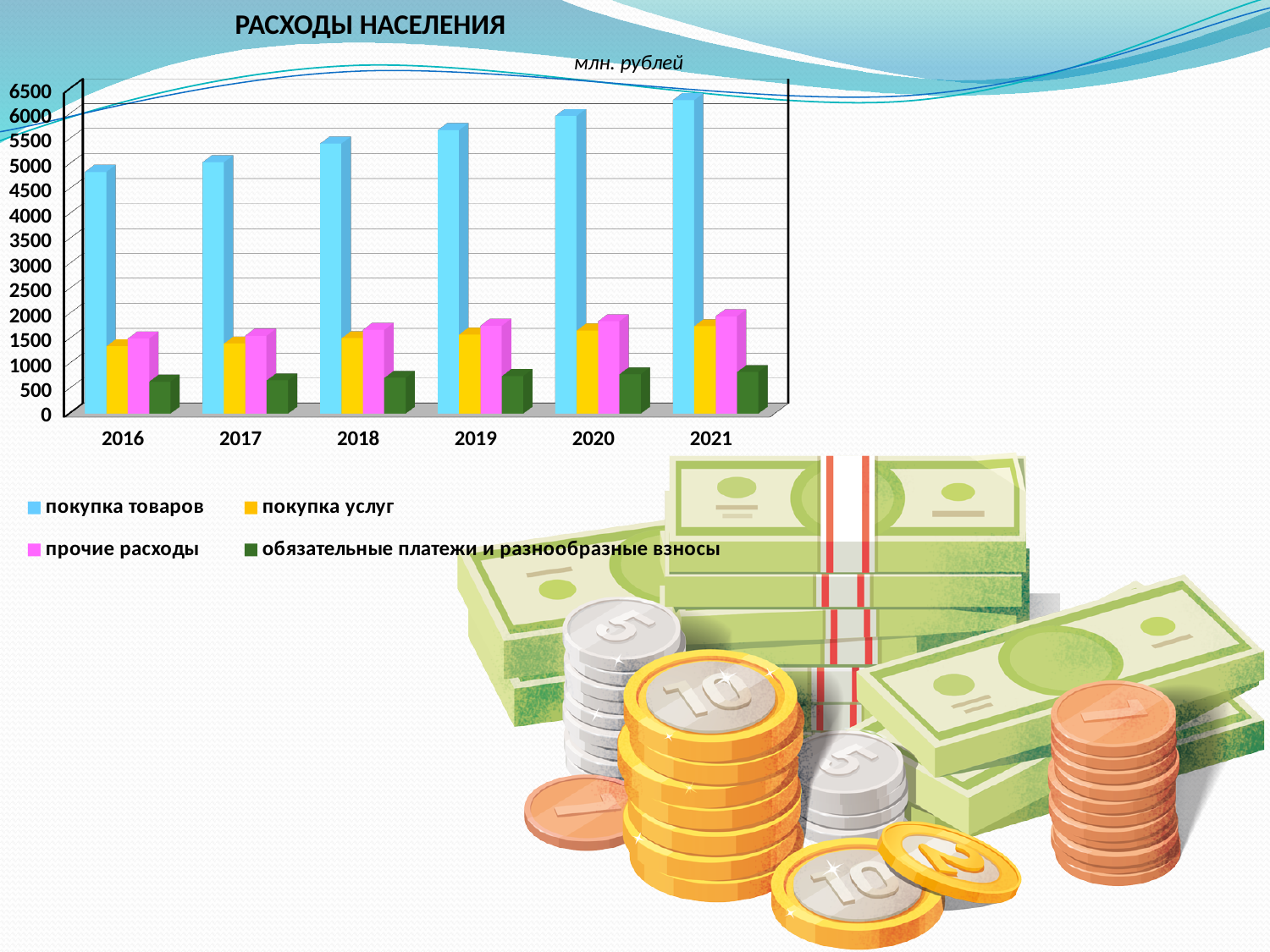
What kind of chart is shown on the slide? bar chart How many years are shown on the x axis? 6 Which is larger in 2019: покупка услуг or обязательные платежи и разнообразные взносы? покупка услуг In which year is the value for покупка товаров the highest? 2021 Do the values for покупка товаров rise or fall from 2016 to 2021? rise Is the value for покупка товаров in 2021 greater or less than 5500? greater How many series does the legend list? 4 Is the value for обязательные платежи и разнообразные взносы in 2016 greater or less than 1000? less What is the title of the chart? РАСХОДЫ НАСЕЛЕНИЯ Which is larger in 2021: прочие расходы or покупка услуг? прочие расходы What unit is indicated for the values on the chart? млн. рублей Is the value for покупка товаров in 2016 greater or less than 4500? greater